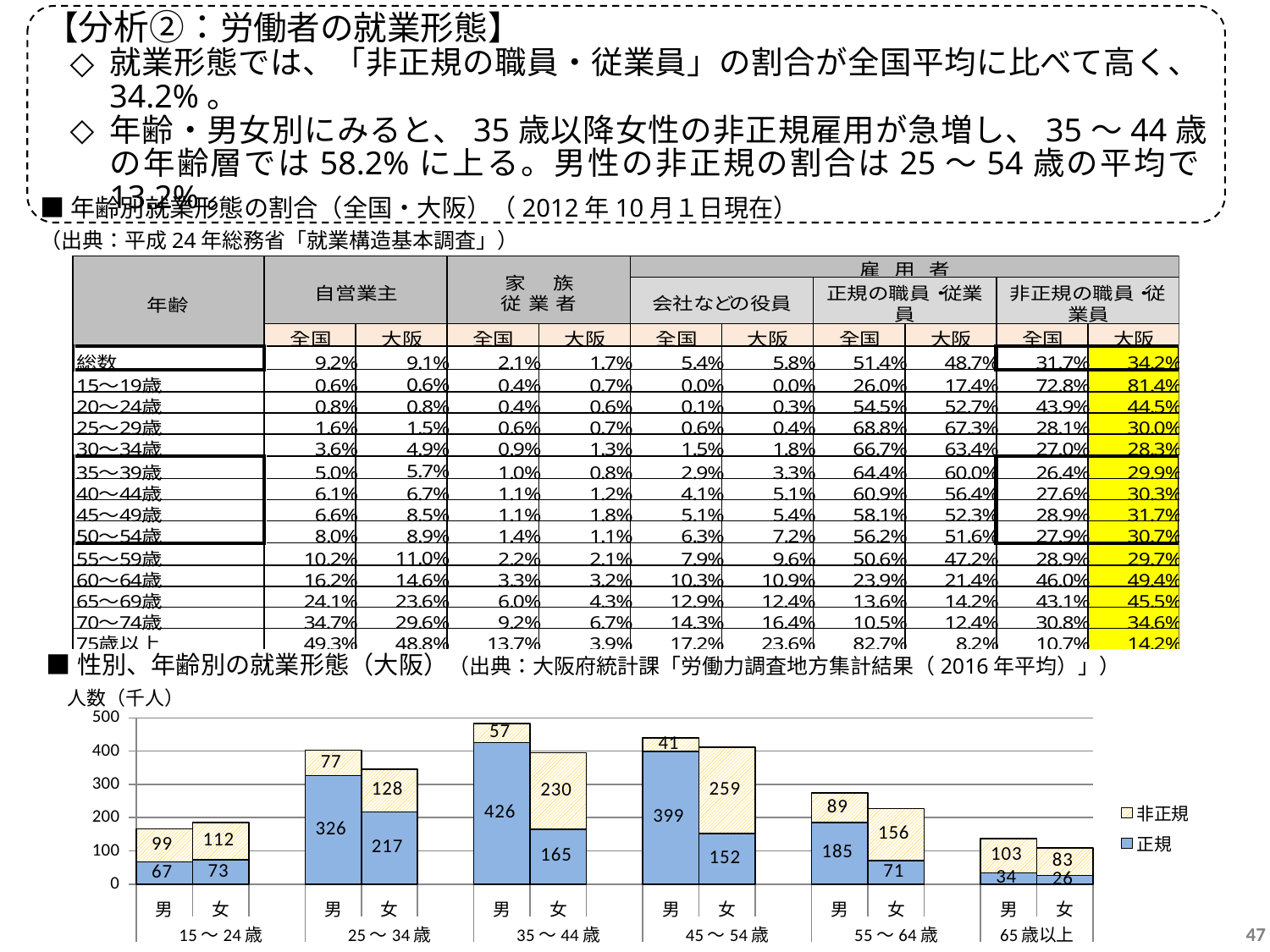
In the bar chart at the bottom of the slide, what is the 非正規 value for 男 in the 65歳以上 group? 103 In the bar chart at the bottom of the slide, what is the 正規 value for 男 in the 35～44歳 group? 426 In the bar chart at the bottom of the slide, how many stacked bars are plotted? 12 In the bar chart at the bottom of the slide, what is the difference between the 正規 values for 男 and 女 in the 25～34歳 group? 109 What kind of chart is shown at the bottom of the slide? Stacked bar chart In the bar chart at the bottom of the slide, which bar has the highest 正規 value? 男, 35～44歳 In the bar chart at the bottom of the slide, what is the total height of the stacked bar for 男 in the 45～54歳 group? 440 In the bar chart at the bottom of the slide, what is the 非正規 value for 女 in the 45～54歳 group? 259 In the bar chart at the bottom of the slide, which bar has the lowest 正規 value? 女, 65歳以上 In the bar chart at the bottom of the slide, which is larger: the 非正規 value for 女 in the 35～44歳 group or the 非正規 value for 女 in the 55～64歳 group? 女, 35～44歳 (230) In the bar chart at the bottom of the slide, how many series does the legend list? 2 In the bar chart at the bottom of the slide, what is the total height of the stacked bar for 女 in the 15～24歳 group? 185